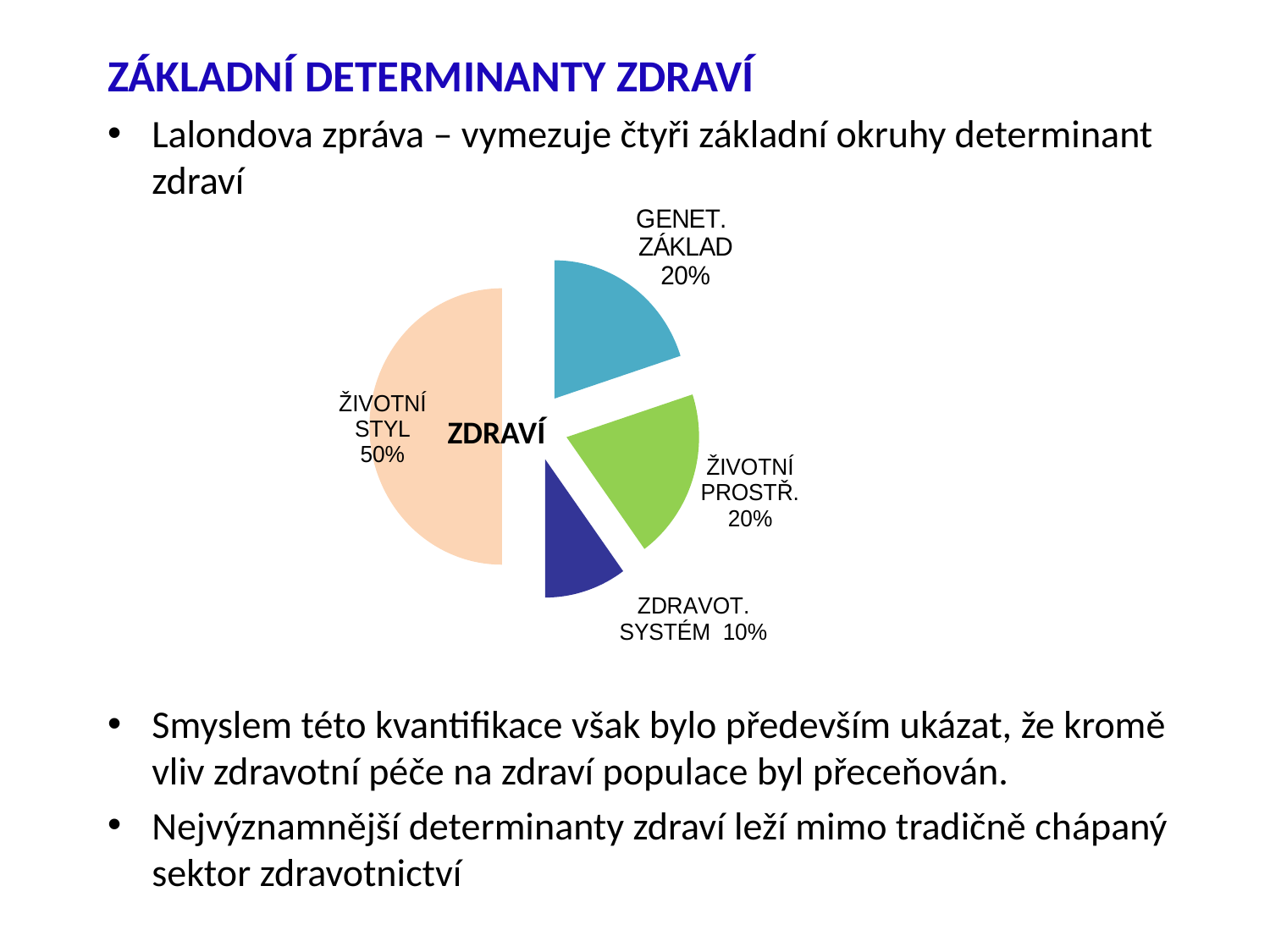
Which slice of the pie is the smallest? ZDRAVOT. SYSTÉM What is the difference between the shares of ŽIVOTNÍ STYL and ZDRAVOT. SYSTÉM? 40% Which is larger, the share of ŽIVOTNÍ PROSTŘ. or the share of ZDRAVOT. SYSTÉM? ŽIVOTNÍ PROSTŘ. What share of the pie does GENET. ZÁKLAD have? 20% How many slices does the pie chart have? 4 What share of the pie does ŽIVOTNÍ STYL have? 50% What word is written in the centre of the pie chart? ZDRAVÍ What share of the pie does ZDRAVOT. SYSTÉM have? 10% What kind of chart is shown on the slide? pie chart Which slice of the pie is the largest? ŽIVOTNÍ STYL What colour is the ŽIVOTNÍ PROSTŘ. slice? green